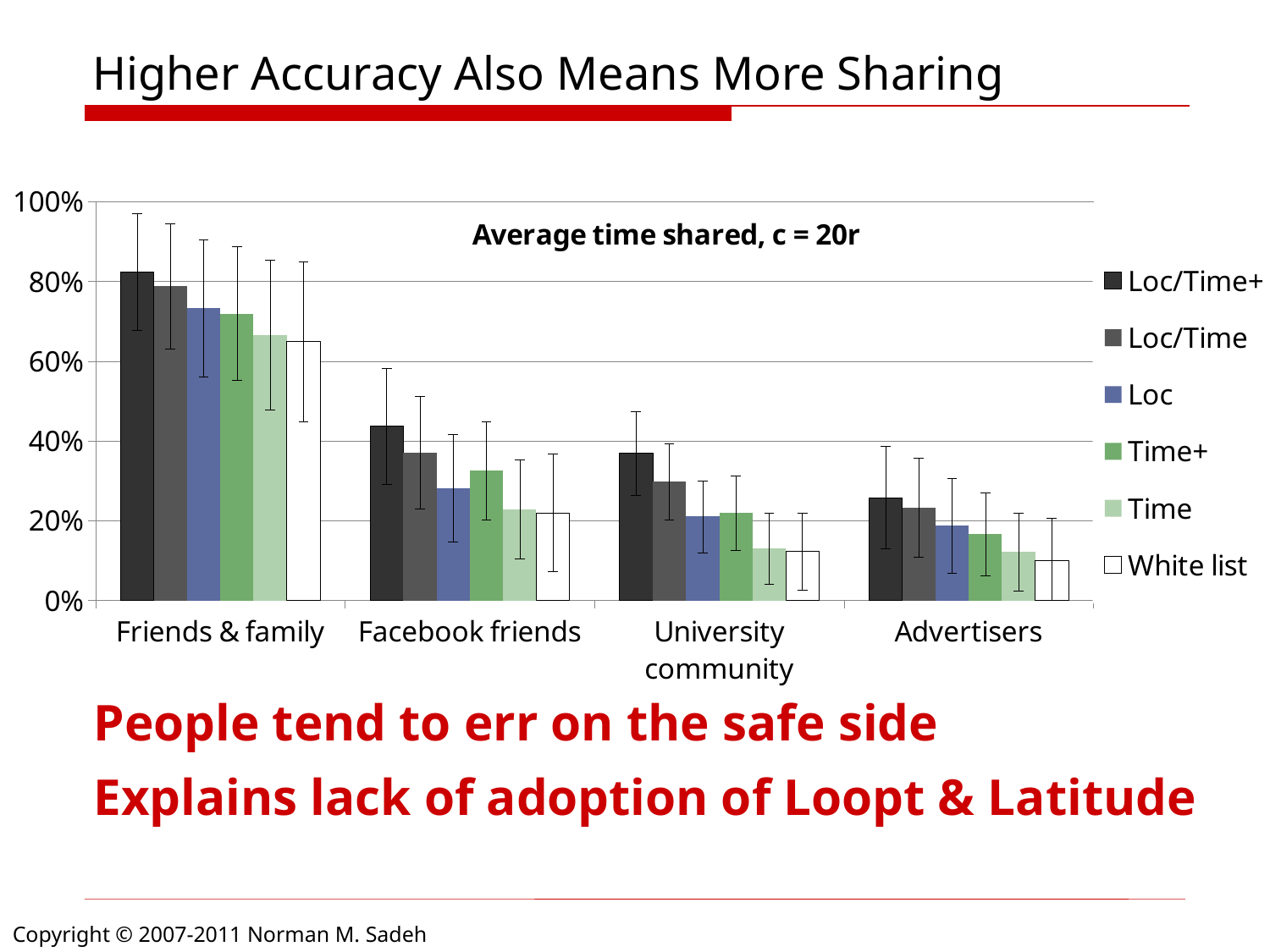
What is the title of the chart? Average time shared, c = 20r Which category has the lowest value for the Loc/Time+ series? Advertisers What kind of chart is shown on the slide? bar chart Which is larger: the Loc/Time+ value for Facebook friends or the Loc/Time+ value for Advertisers? Facebook friends Is the value for Loc/Time+ in the Friends & family category greater or less than 60%? greater Which series is shown with white (unfilled) bars in the chart? White list Which category has the highest value for the Loc/Time+ series? Friends & family How many categories are shown on the x axis of the chart? 4 Is the value for Time in the Advertisers category greater or less than 20%? less How many series does the chart's legend list? 6 Do the Loc/Time+ values rise or fall moving from Friends & family to Advertisers along the x axis? fall Is the value for Loc/Time+ in the University community category greater or less than 40%? less